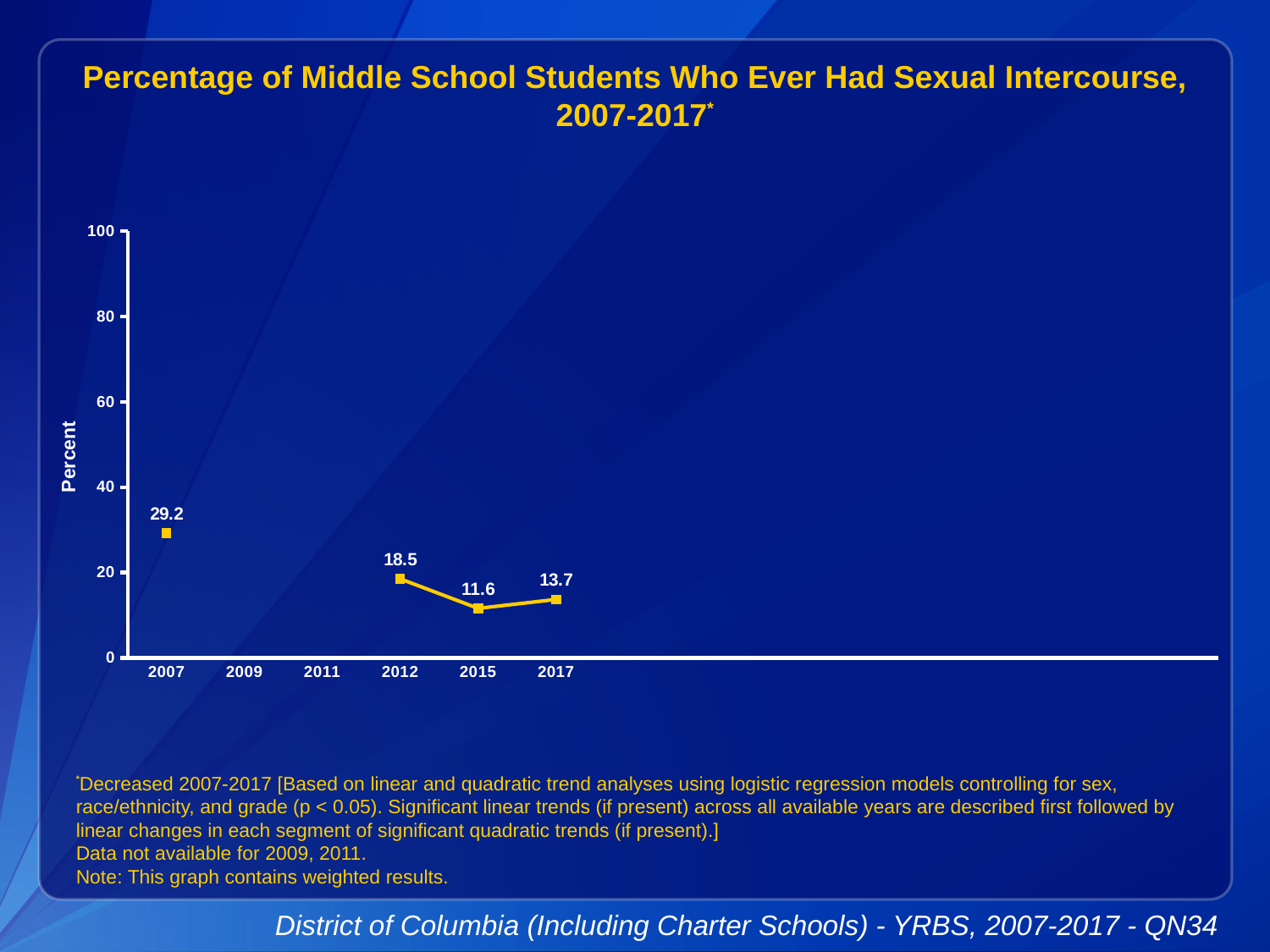
Is the value for 2007 greater or less than 20? greater Which year has the highest value? 2007 Which year has the lowest value? 2015 What is the value for 2015? 11.6 What is the label of the y axis? Percent What is the value for 2017? 13.7 What kind of chart is this? line chart How many years have a plotted data point? 4 What is the value for 2012? 18.5 Which is larger, the value for 2012 or the value for 2017? 2012 What is the value for 2007? 29.2 What is the difference between the values for 2007 and 2017? 15.5